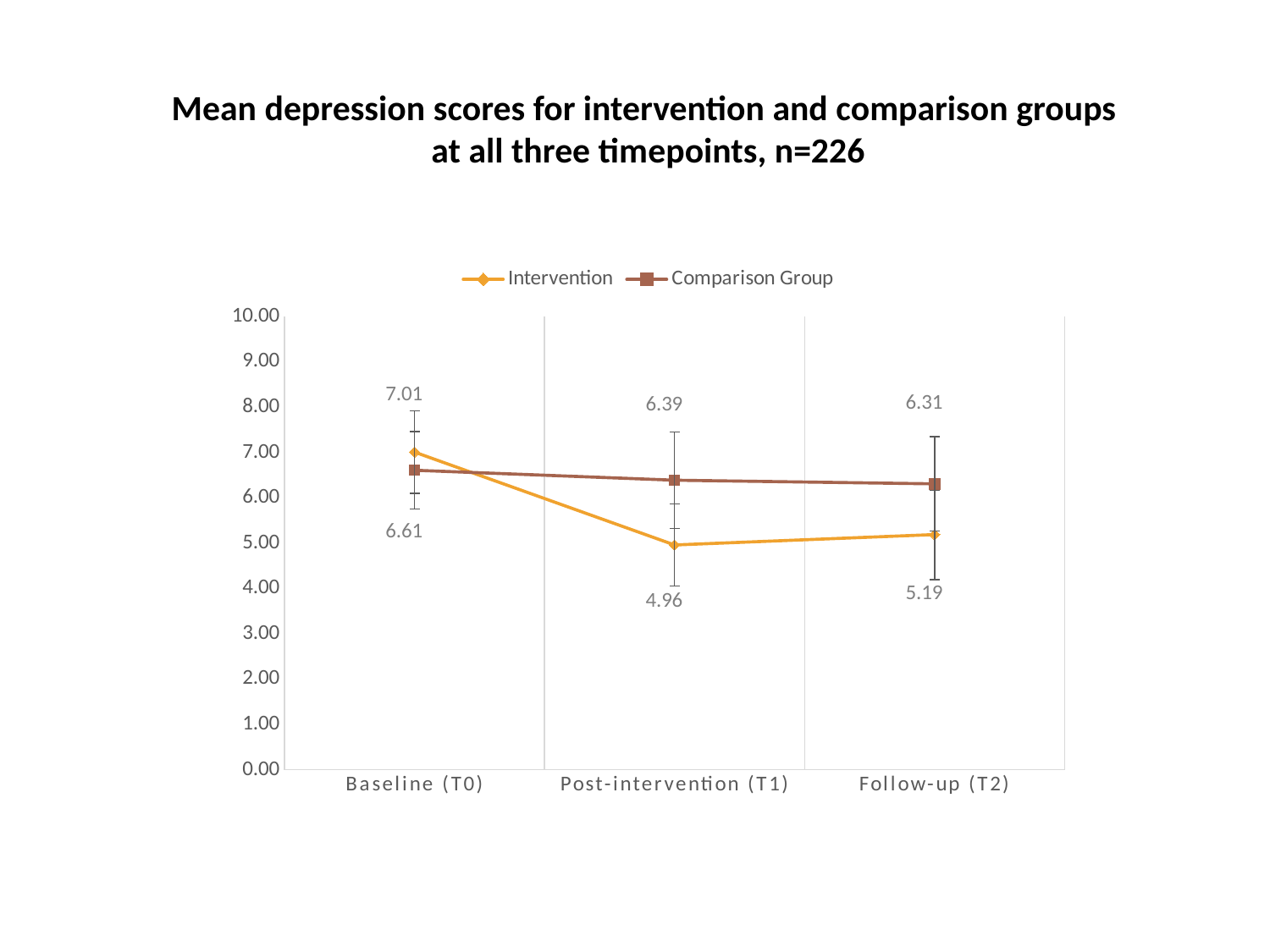
How many series does the legend list? 2 How many timepoints are shown on the x axis? 3 At which timepoint is the Comparison Group's mean depression score highest? Baseline (T0) What is the mean depression score for the Intervention group at Baseline (T0)? 7.01 What kind of chart is shown on the slide? Line chart What is the mean depression score for the Comparison Group at Follow-up (T2)? 6.31 At Baseline (T0), which group has the higher mean depression score? Intervention What is the mean depression score for the Intervention group at Follow-up (T2)? 5.19 At Follow-up (T2), which group has the higher mean depression score? Comparison Group What is the mean depression score for the Comparison Group at Post-intervention (T1)? 6.39 At which timepoint is the Intervention group's mean depression score lowest? Post-intervention (T1) What is the difference between the Intervention group's score at Baseline (T0) and at Post-intervention (T1)? 2.05